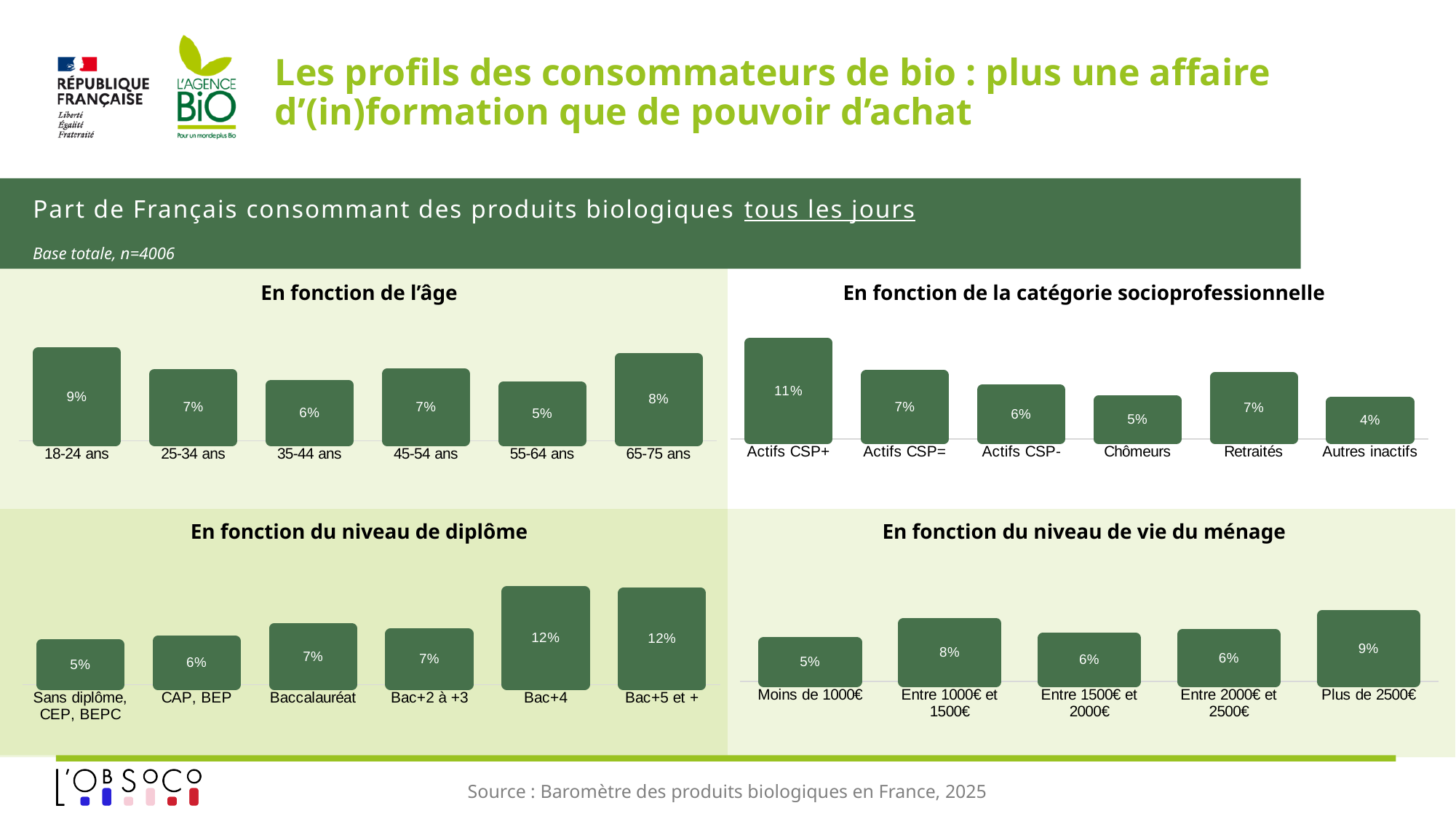
In the chart 'En fonction de l'âge', what is the value for 18-24 ans? 9% In the chart 'En fonction du niveau de vie du ménage', what is the value for Plus de 2500€? 9% What kind of chart is 'En fonction de l'âge'? Bar chart In the chart 'En fonction du niveau de diplôme', which is larger, Bac+4 or Sans diplôme, CEP, BEPC? Bac+4 In the chart 'En fonction de la catégorie socioprofessionnelle', what is the value for Autres inactifs? 4% In the chart 'En fonction de la catégorie socioprofessionnelle', which category has the highest value? Actifs CSP+ In the chart 'En fonction du niveau de diplôme', what is the value for Baccalauréat? 7% In the chart 'En fonction de l'âge', which age group has the lowest value? 55-64 ans In the chart 'En fonction du niveau de vie du ménage', what is the difference between Entre 1000€ et 1500€ and Moins de 1000€? 3% In the chart 'En fonction de la catégorie socioprofessionnelle', what is the difference between Actifs CSP+ and Chômeurs? 6% In the chart 'En fonction du niveau de diplôme', how many categories are shown? 6 In the chart 'En fonction du niveau de vie du ménage', which category has the lowest value? Moins de 1000€